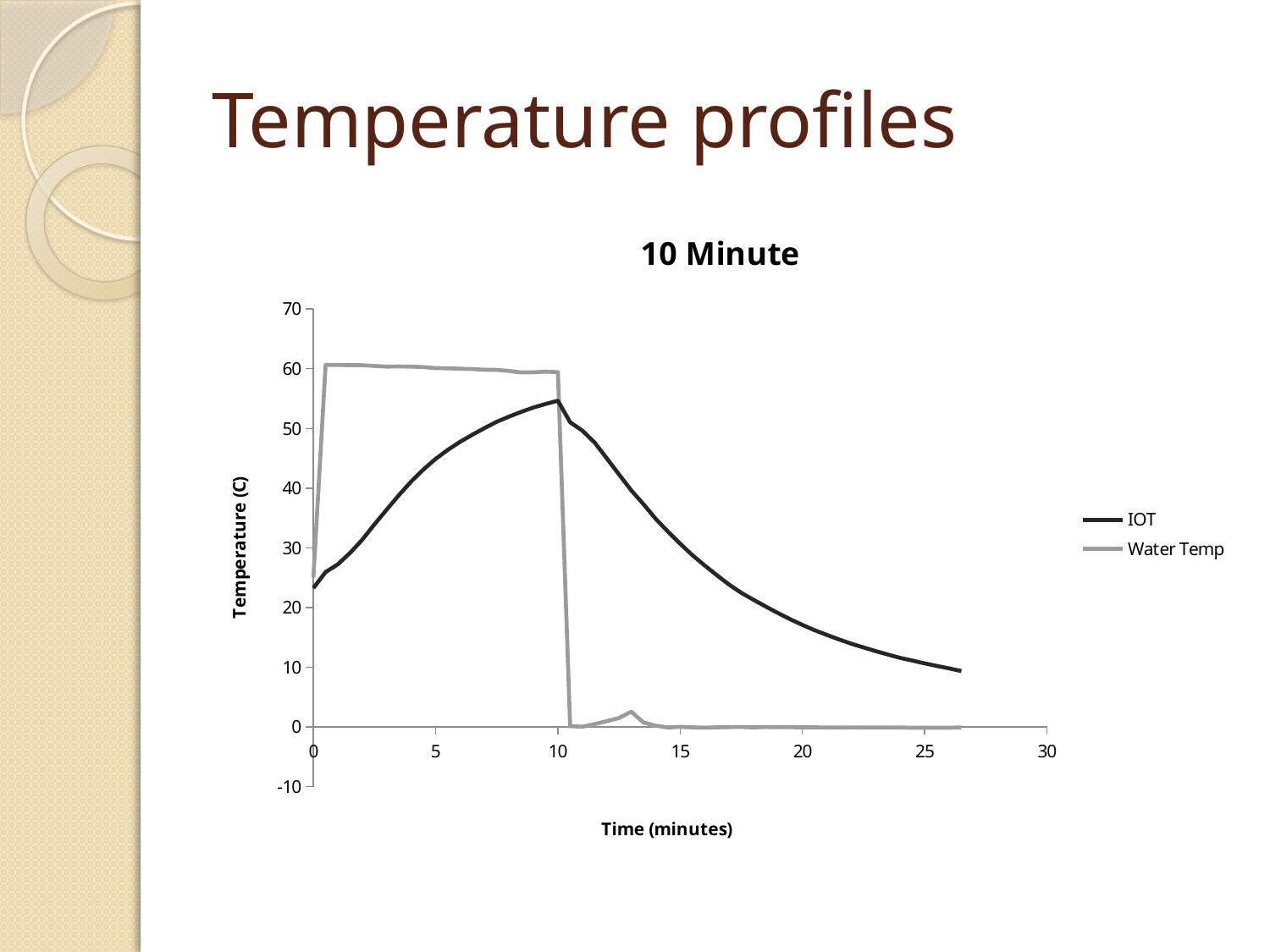
Is the Water Temp value at 5 minutes greater or less than 50? greater What kind of chart is shown on the slide? line chart Is the peak IOT value greater or less than 60? less At 15 minutes, which series has the higher temperature, IOT or Water Temp? IOT Is the IOT value at 20 minutes greater or less than 30? less Does the IOT series rise or fall between 10 and 25 minutes? fall What are the two series named in the legend? IOT and Water Temp What is the title of the chart? 10 Minute How many series does the legend list? 2 At 5 minutes, which series has the higher temperature, IOT or Water Temp? Water Temp